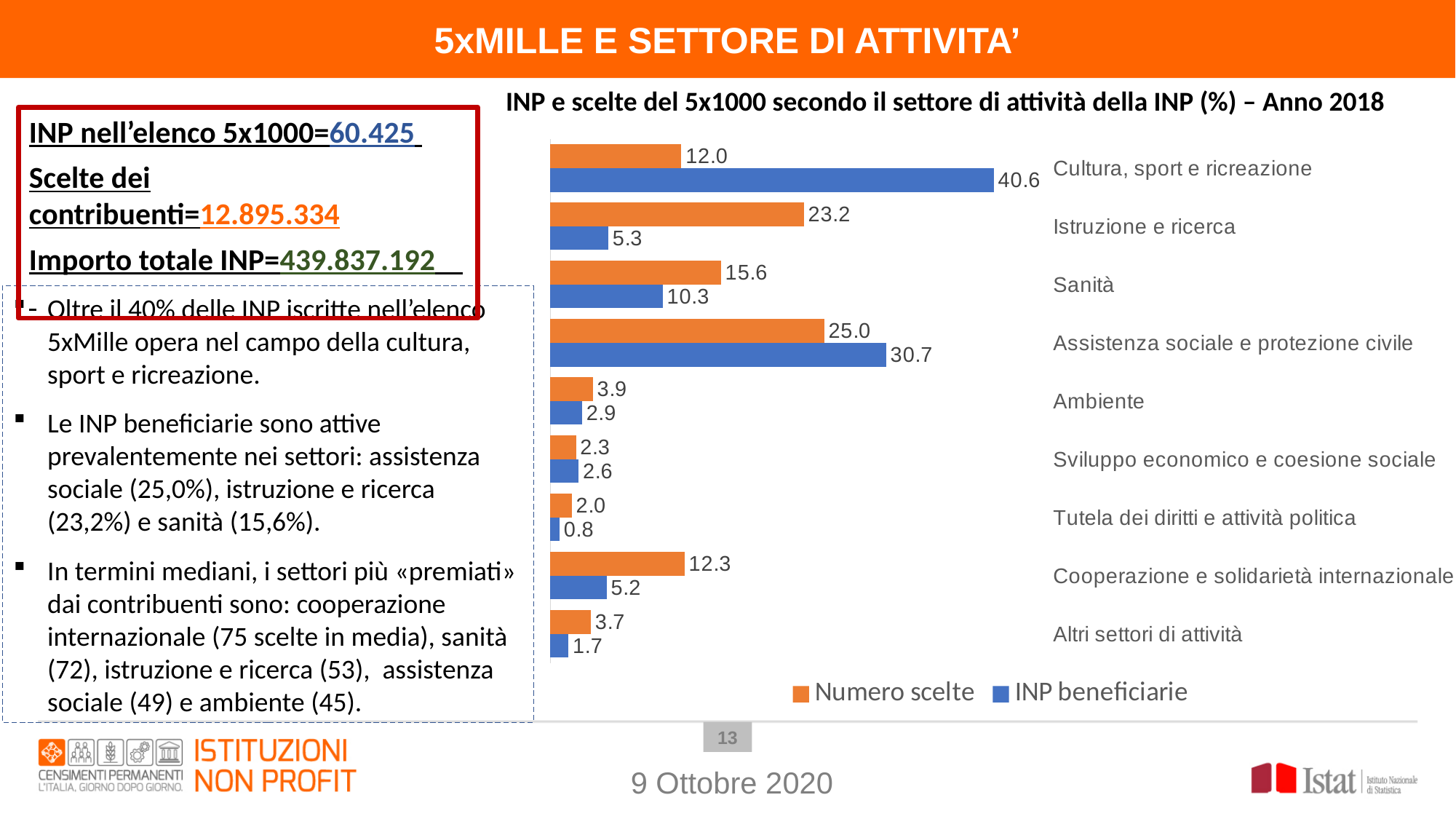
What is the difference between INP beneficiarie and Numero scelte for Cultura, sport e ricreazione? 28.6 What is the value of INP beneficiarie for Assistenza sociale e protezione civile? 30.7 For Sanità, which series has the larger value, Numero scelte or INP beneficiarie? Numero scelte Which category has the lowest value for INP beneficiarie? Tutela dei diritti e attività politica What kind of chart is shown on the slide? Bar chart What is the value of Numero scelte for Istruzione e ricerca? 23.2 How many categories are shown in the chart? 9 What is the value of Numero scelte for Cooperazione e solidarietà internazionale? 12.3 How many series does the legend list? 2 Which colour represents the INP beneficiarie series in the chart? Blue Which category has the highest value for Numero scelte? Assistenza sociale e protezione civile What is the value of INP beneficiarie for Cultura, sport e ricreazione? 40.6